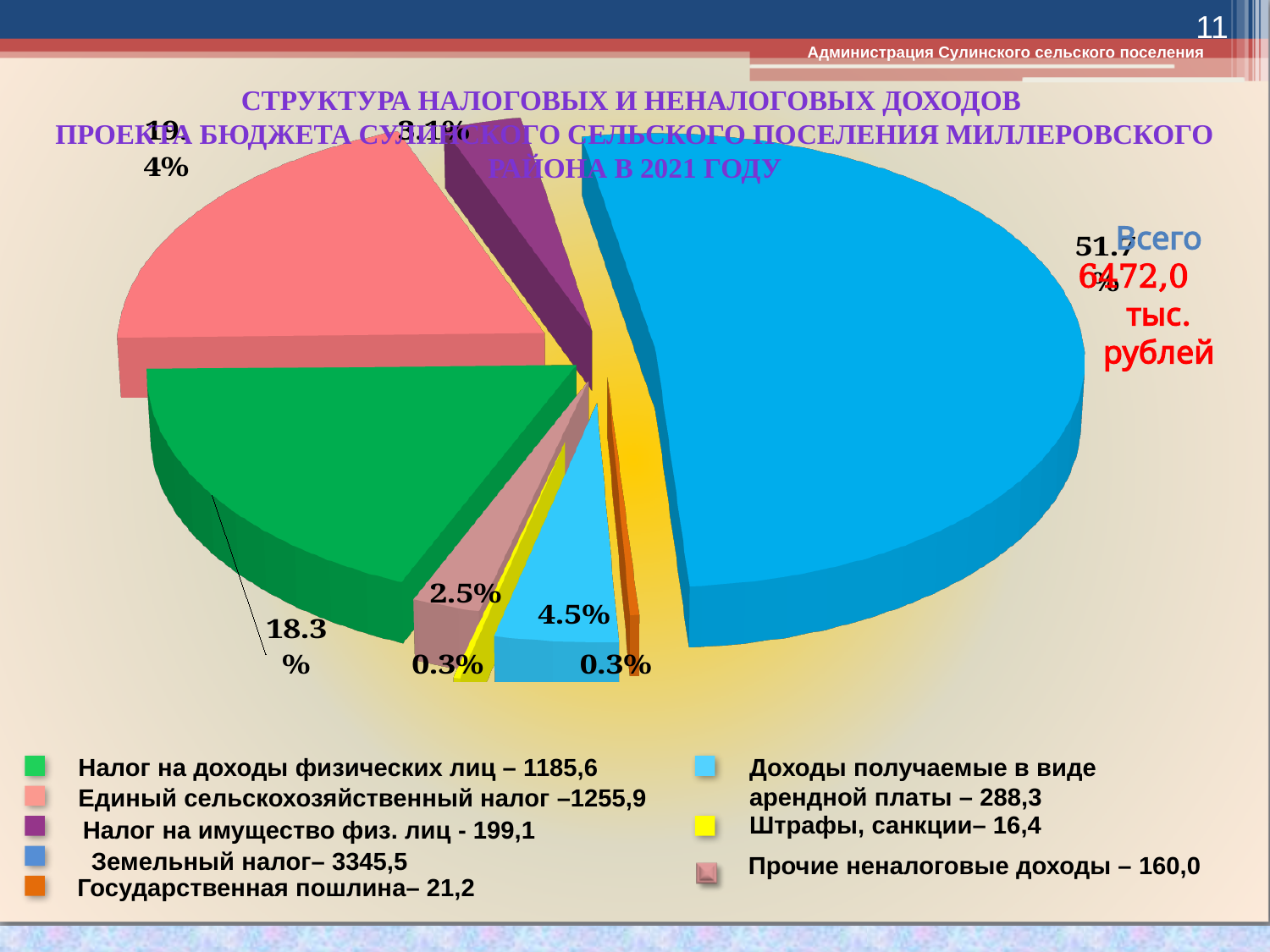
What share of the pie does Налог на имущество физ. лиц (the purple slice) represent? 3.1% What share of the pie does Налог на доходы физических лиц (the green slice) represent? 18.3% What share of the pie does Доходы получаемые в виде арендной платы (the light blue slice) represent? 4.5% What total amount (Всего) is stated next to the pie chart? 6472,0 тыс. рублей Which is larger, the slice for Налог на доходы физических лиц or the slice for Единый сельскохозяйственный налог? Единый сельскохозяйственный налог How many categories does the legend list? 8 What is the difference in percentage points between the Земельный налог slice (51.7%) and the Налог на доходы физических лиц slice (18.3%)? 33.4 What kind of chart is shown on the slide? pie chart What value is given in the legend for Государственная пошлина? 21,2 What value is given in the legend for Единый сельскохозяйственный налог? 1255,9 Which category has the largest slice of the pie? Земельный налог